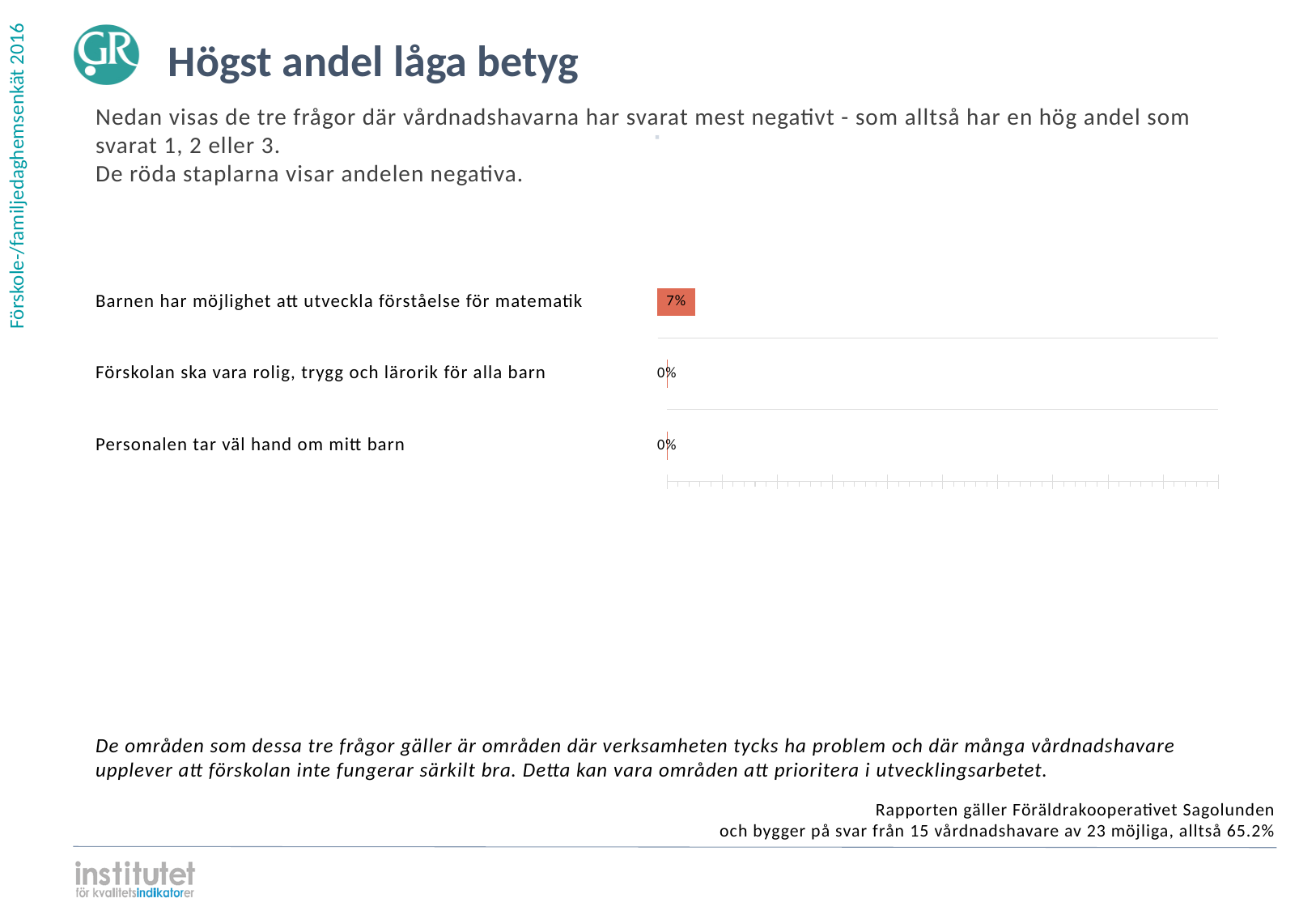
How many categories in the chart have a value of 0%? 2 Which category has the highest value in the chart? Barnen har möjlighet att utveckla förståelse för matematik What is the value for "Personalen tar väl hand om mitt barn"? 0% What kind of chart is shown on the slide? Bar chart What is the difference between the value for "Barnen har möjlighet att utveckla förståelse för matematik" and the value for "Personalen tar väl hand om mitt barn"? 7% How many categories are shown in the chart? 3 What is the value for "Förskolan ska vara rolig, trygg och lärorik för alla barn"? 0% Which is larger: the value for "Barnen har möjlighet att utveckla förståelse för matematik" or the value for "Förskolan ska vara rolig, trygg och lärorik för alla barn"? Barnen har möjlighet att utveckla förståelse för matematik What is the value for "Barnen har möjlighet att utveckla förståelse för matematik"? 7% What is the title of the slide containing the chart? Högst andel låga betyg What colour are the bars in the chart? Red